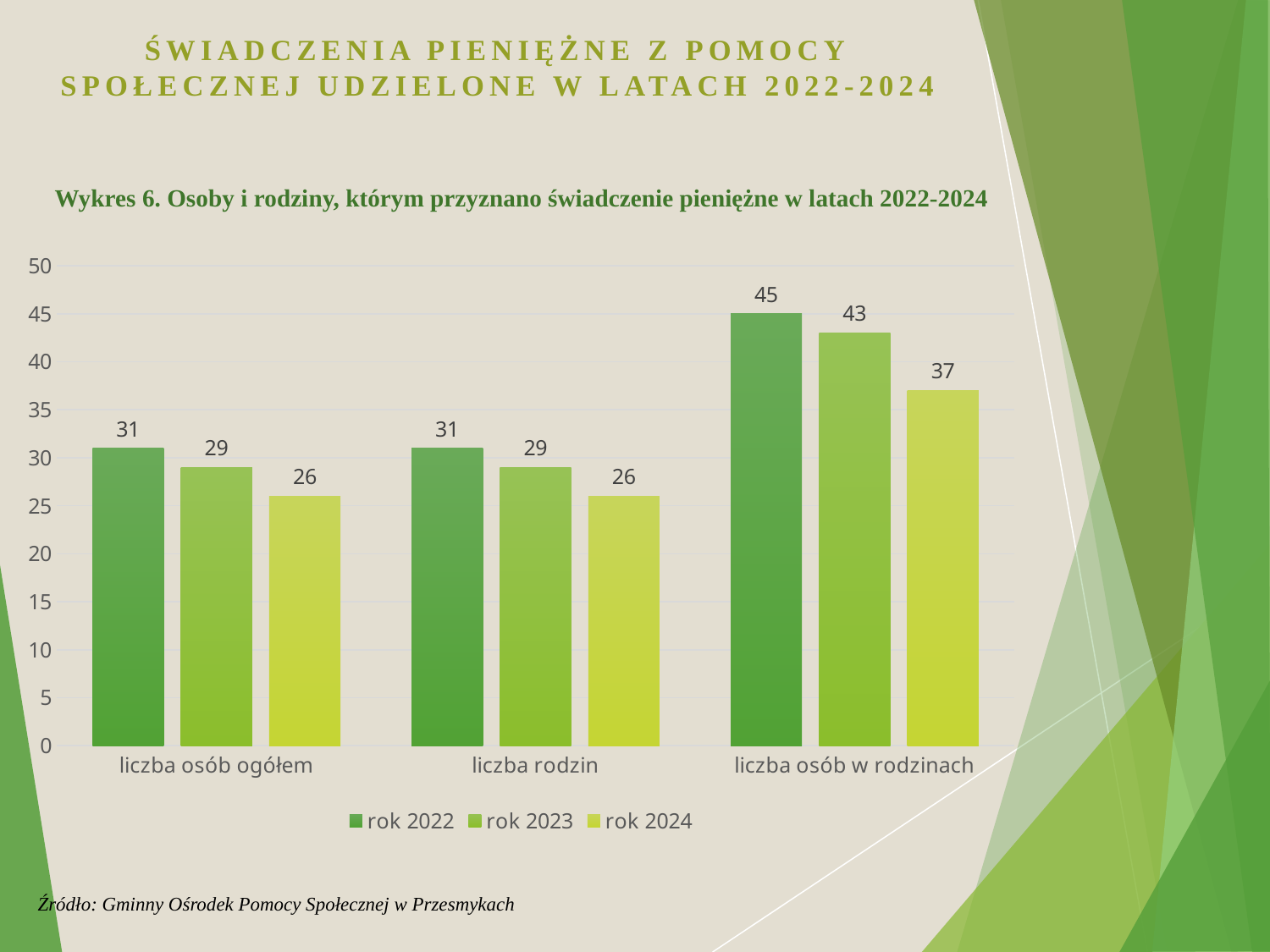
Which year has the lowest value for 'liczba osób w rodzinach'? rok 2024 What is the difference between the rok 2022 and rok 2024 values for 'liczba osób w rodzinach'? 8 Which category has the highest value in rok 2024? liczba osób w rodzinach What is the difference between the rok 2022 and rok 2023 values for 'liczba osób ogółem'? 2 How many categories are shown on the x axis? 3 What is the value for 'liczba osób ogółem' in rok 2023? 29 How many series does the legend list? 3 Do the values for 'liczba rodzin' rise or fall from rok 2022 to rok 2024? fall Which is larger: the rok 2023 value for 'liczba osób w rodzinach' or the rok 2022 value for 'liczba rodzin'? rok 2023 value for 'liczba osób w rodzinach' What kind of chart is shown on the slide? bar chart What is the value for 'liczba rodzin' in rok 2024? 26 What is the value for 'liczba osób w rodzinach' in rok 2022? 45